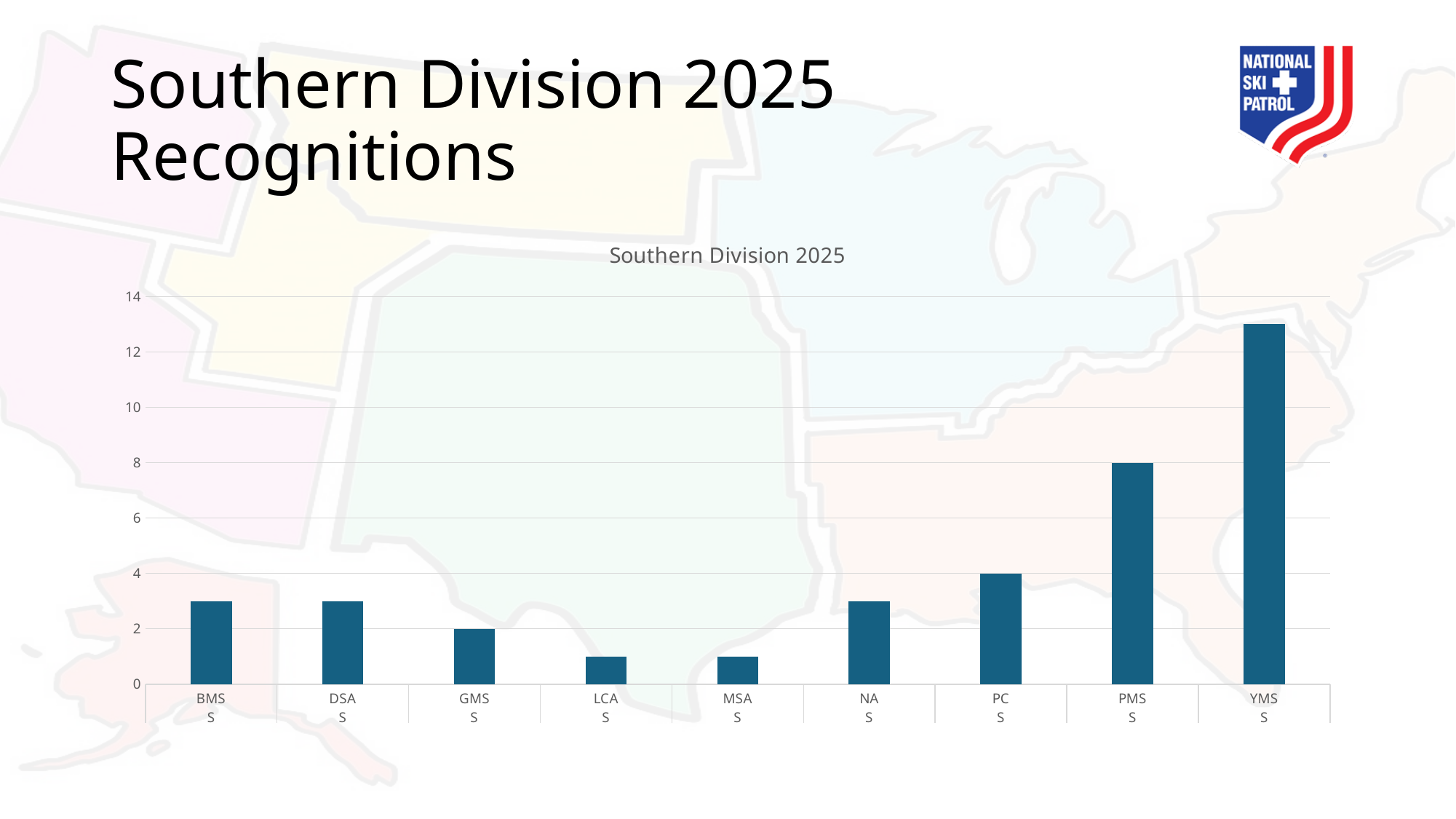
What is the difference between the values for PMS and PC? 4 What is the title of the chart? Southern Division 2025 Which category has the highest value in the chart? YMS Is the value for YMS greater or less than 12? greater What is the value for PC? 4 What is the value for GMS? 2 Which is larger, the value for PMS or the value for PC? PMS How many categories are shown on the x axis of the chart? 9 What is the value for PMS? 8 What type of chart is shown on the slide? bar chart Is the value for BMS greater or less than 4? less Is the value for LCA greater or less than 2? less